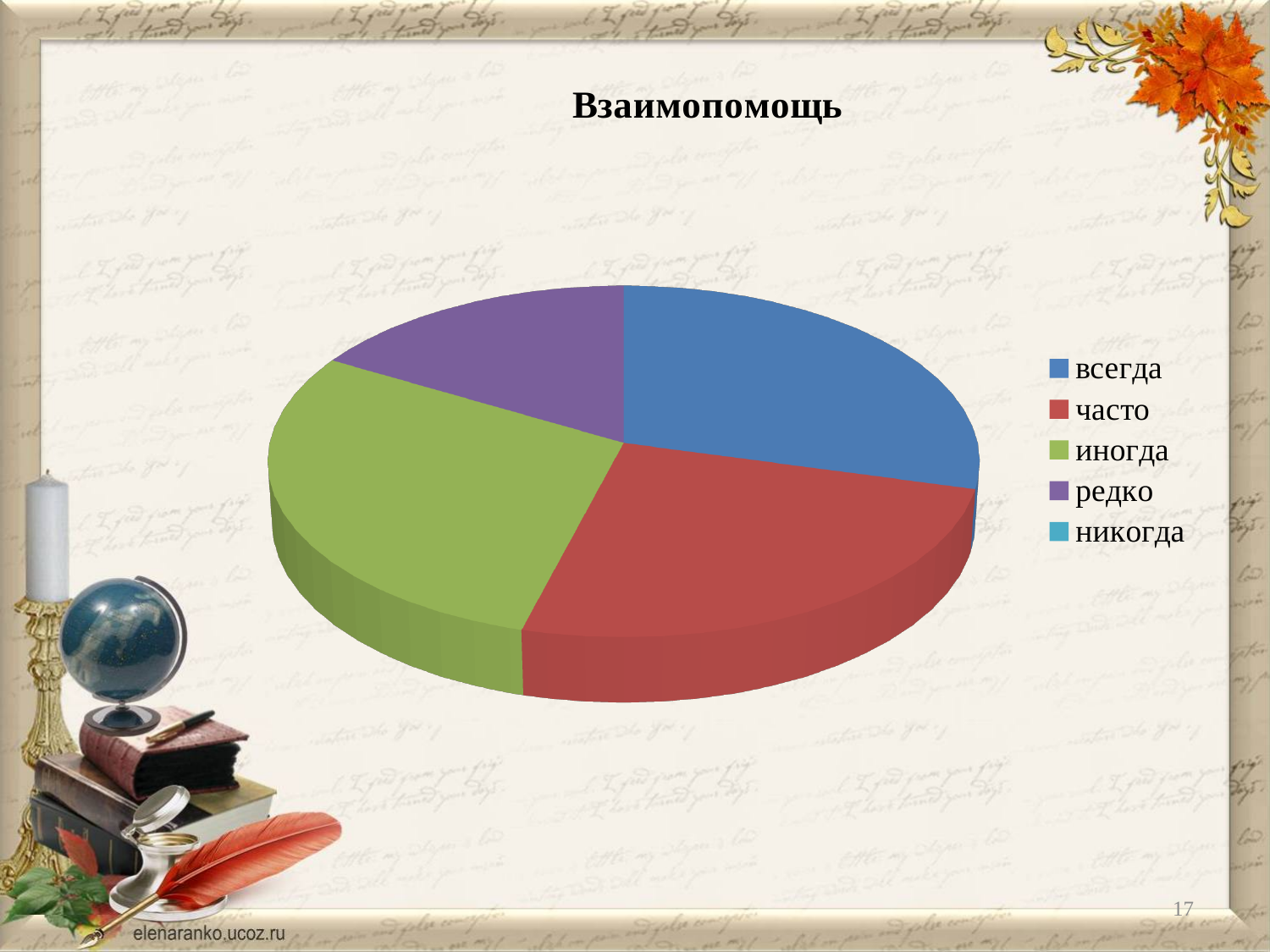
Which is larger in the pie chart, the slice for "всегда" or the slice for "редко"? всегда What kind of chart is shown on the slide? pie chart Which colour represents the category "иногда" in the chart? green Which is larger in the pie chart, the slice for "иногда" or the slice for "редко"? иногда What is the title of the chart? Взаимопомощь How many categories does the chart's legend list? 5 Which is larger in the pie chart, the slice for "часто" or the slice for "редко"? часто